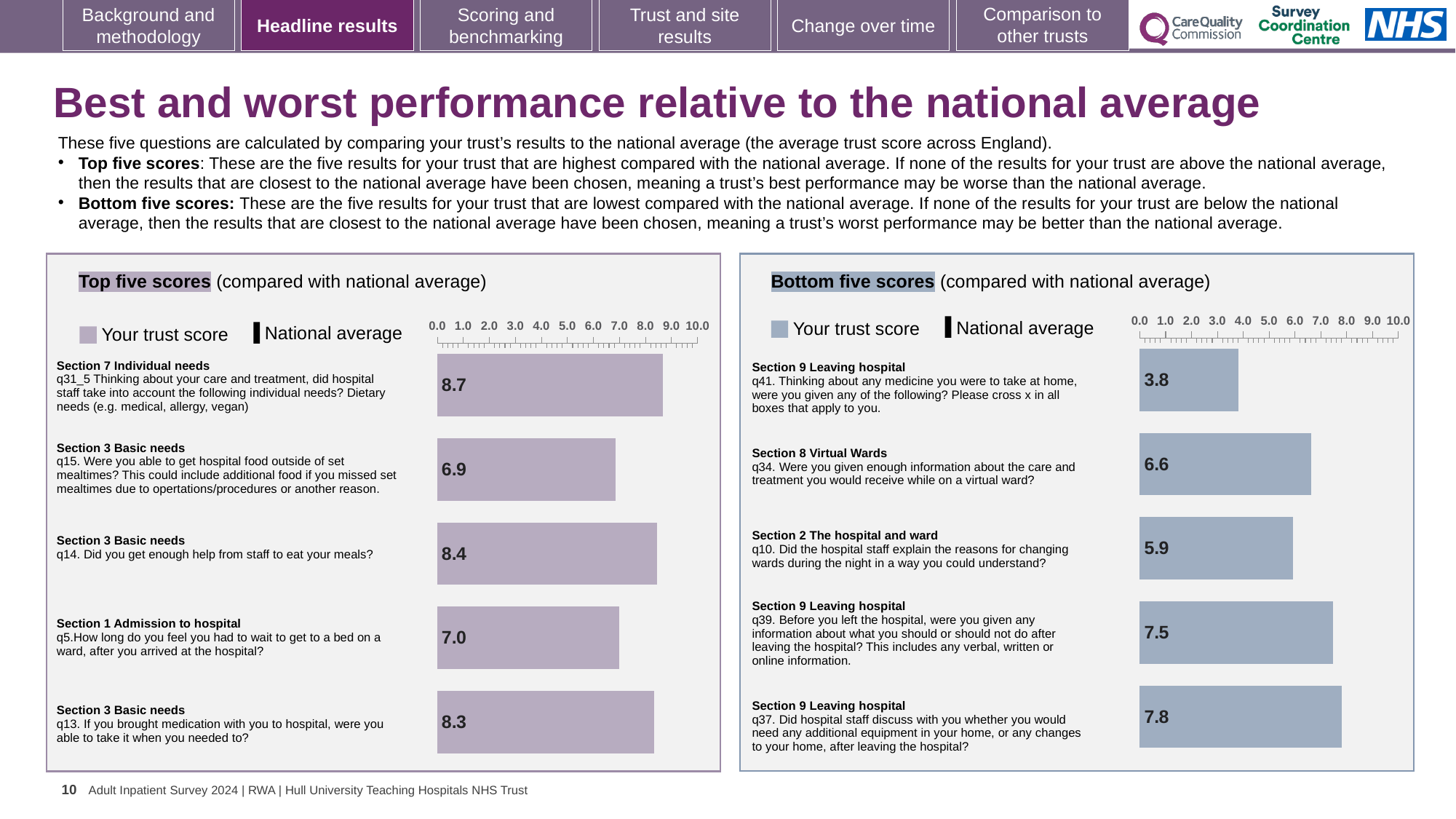
What kind of chart is used in the Top five scores panel? Bar chart In the Bottom five scores chart, what is the difference between the trust scores for q37 and q41? 4.0 In the Top five scores chart, what is the trust score for q5 (how long you had to wait to get to a bed on a ward)? 7.0 In the Top five scores chart, which question has the lowest trust score? q15 (hospital food outside of set mealtimes), 6.9 In the Bottom five scores chart, which has the larger trust score: q39 or q37? q37 (7.8) In the Top five scores chart, what is the trust score for q14 (Did you get enough help from staff to eat your meals?)? 8.4 In the Bottom five scores chart, what is the trust score for q34 (Section 8 Virtual Wards)? 6.6 In the Bottom five scores chart, is the trust score for q41 greater or less than 4.0? less In the Top five scores chart, what is the difference between the trust scores for q31_5 and q15? 1.8 In the Bottom five scores chart, which question has the highest trust score? q37 (additional equipment or changes to your home), 7.8 In the Top five scores chart, which question has the highest trust score? q31_5 (Dietary needs), 8.7 In the Bottom five scores chart, which question has the lowest trust score? q41 (medicine to take at home), 3.8